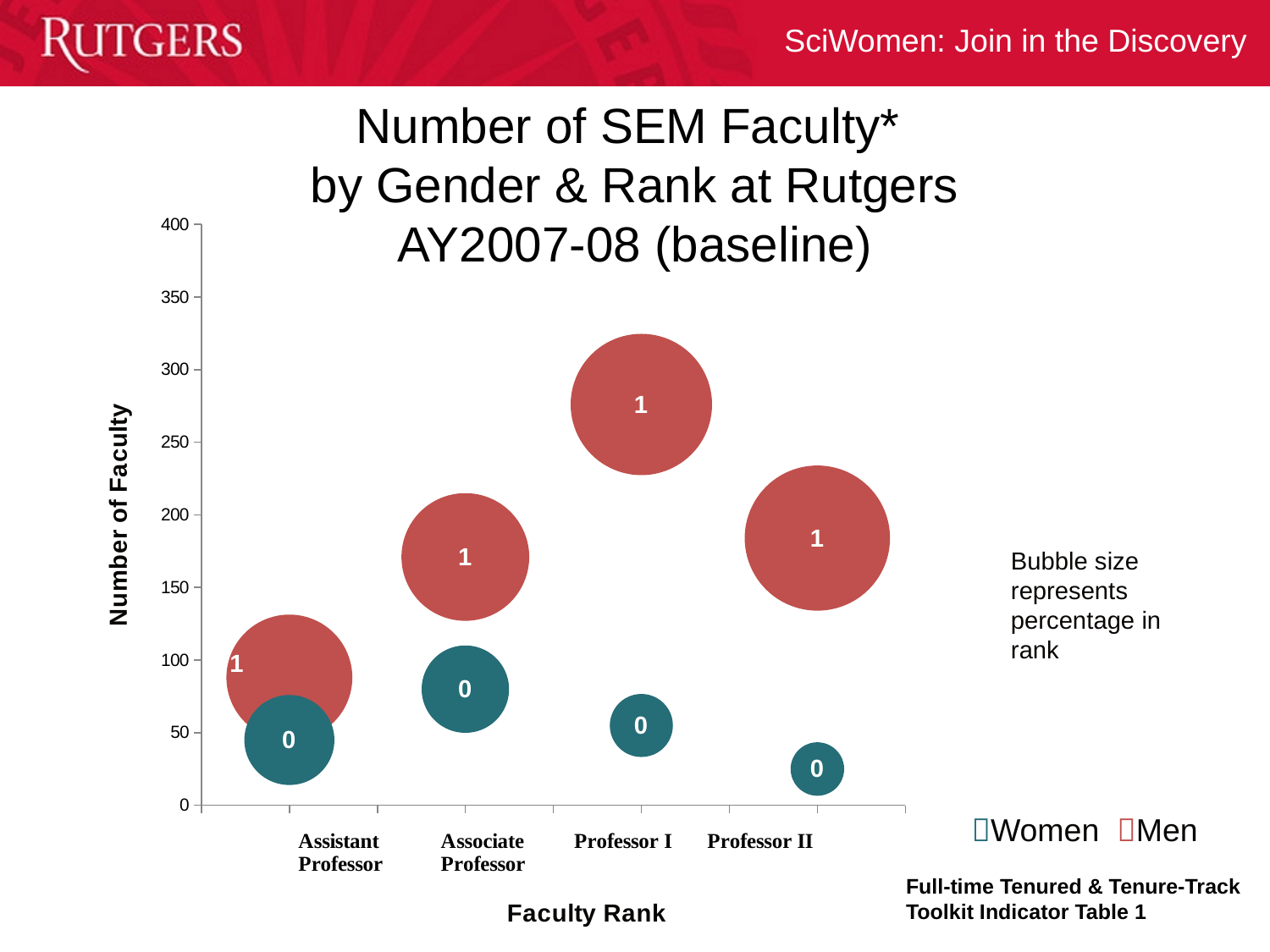
For which faculty rank is the number of men lowest? Assistant Professor Is the number of men at the Associate Professor rank greater or less than 150? greater According to the note on the slide, what does the bubble size represent? Percentage in rank What kind of chart is shown on the slide? Bubble chart At the Professor I rank, which is larger: the number of men or the number of women? Men Is the number of women at the Professor II rank greater or less than 50? less How many series does the legend list? 2 Which is larger: the number of women at Associate Professor or the number of women at Professor I? Associate Professor For which faculty rank is the number of women lowest? Professor II Is the number of men at the Professor I rank greater or less than 250? greater For which faculty rank is the number of men highest? Professor I How many faculty ranks are shown along the x axis? 4